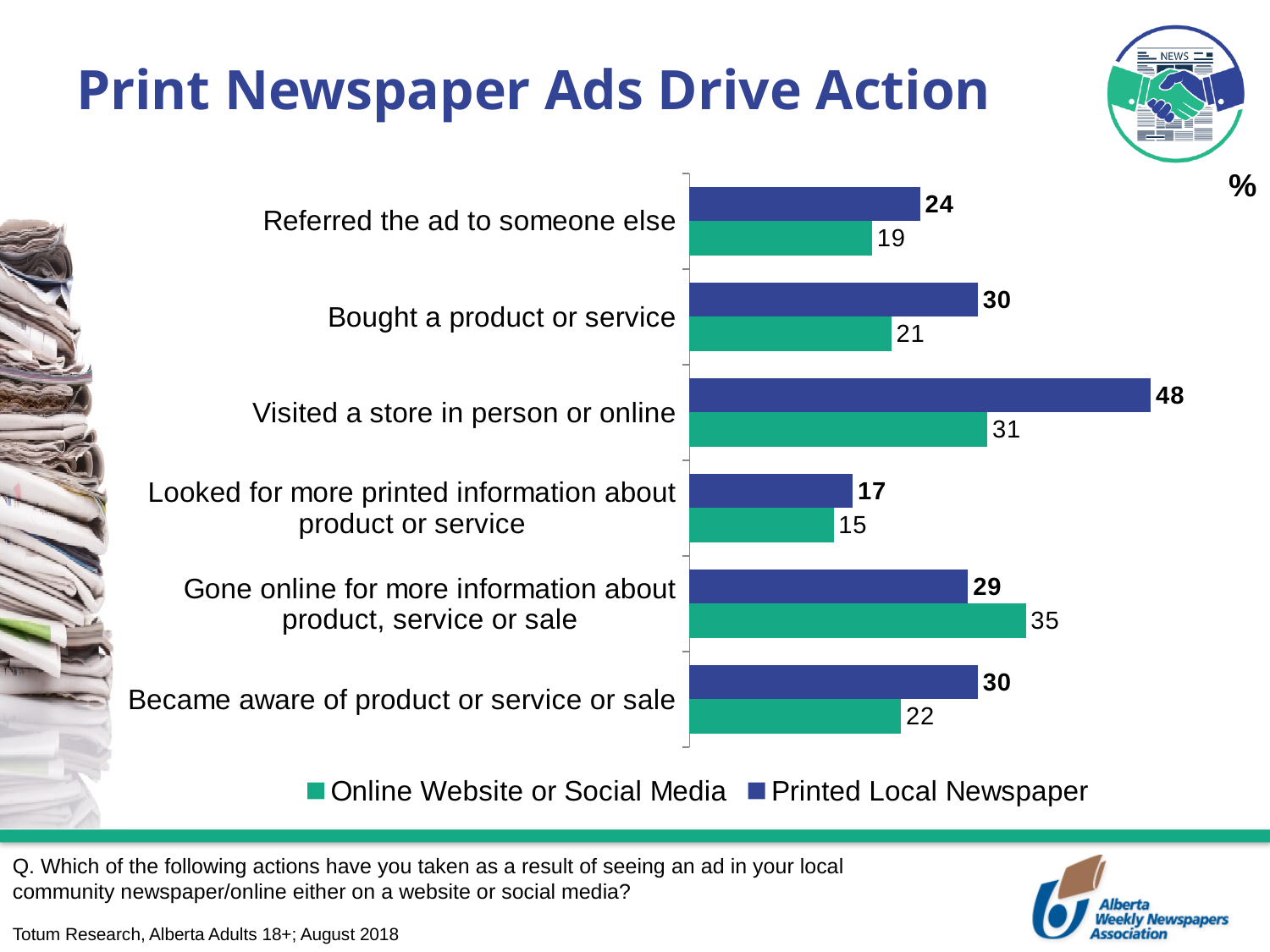
For "Gone online for more information about product, service or sale", which series has the larger value: Printed Local Newspaper or Online Website or Social Media? Online Website or Social Media What is the Printed Local Newspaper value for "Became aware of product or service or sale"? 30 Which category has the lowest Online Website or Social Media value? Looked for more printed information about product or service How many categories are shown on the chart? 6 What is the Online Website or Social Media value for "Gone online for more information about product, service or sale"? 35 How many series does the legend list? 2 What is the Online Website or Social Media value for "Referred the ad to someone else"? 19 Which colour represents the Printed Local Newspaper series? Blue What is the difference between the Printed Local Newspaper and Online Website or Social Media values for "Visited a store in person or online"? 17 Which category has the highest Printed Local Newspaper value? Visited a store in person or online What kind of chart is shown on the slide? Bar chart What is the Printed Local Newspaper value for "Visited a store in person or online"? 48